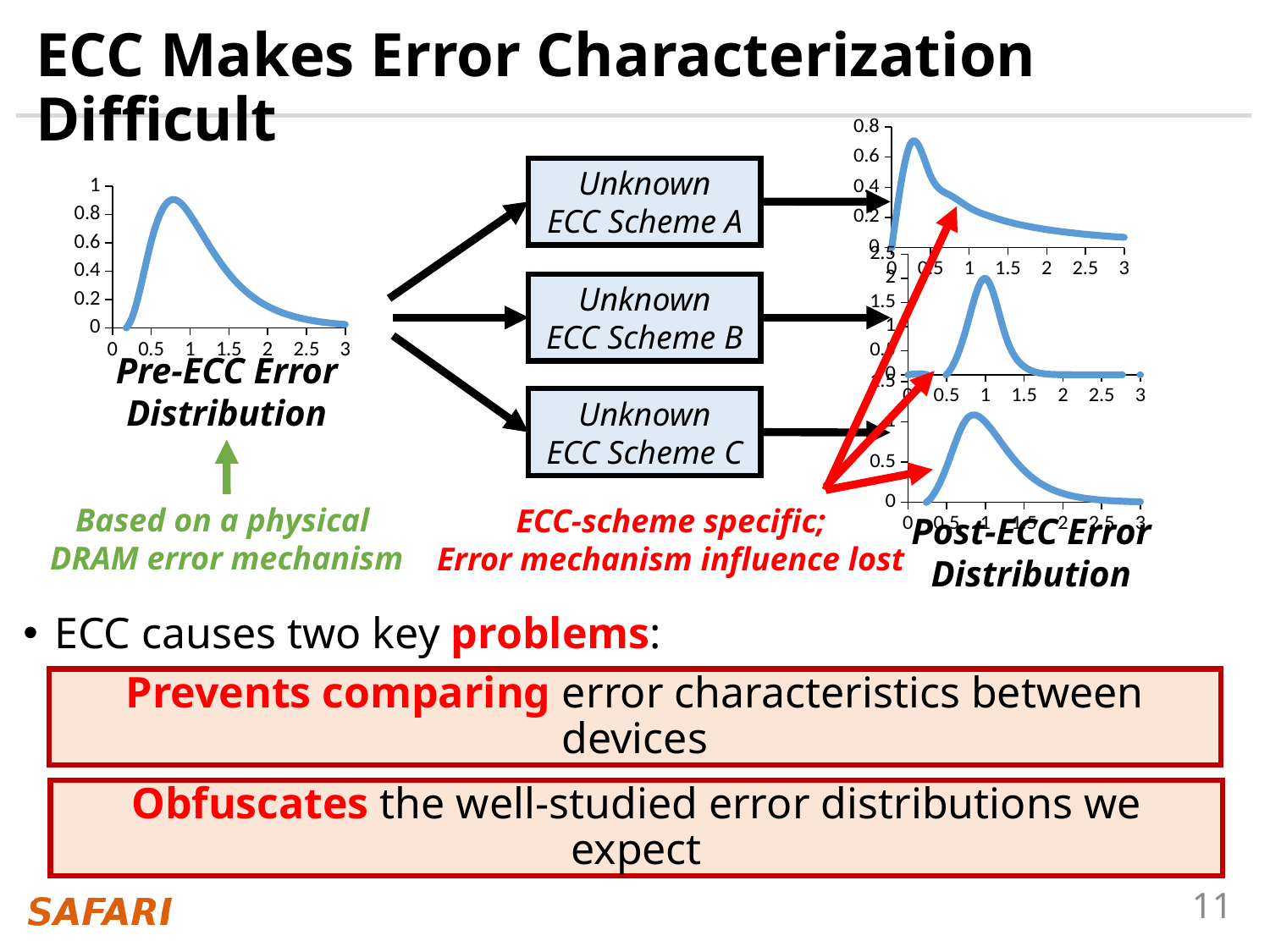
What is the highest tick shown on the y axis of the middle Post-ECC Error Distribution chart? 2.5 In the top Post-ECC Error Distribution chart, is the peak value greater or less than 0.6? greater In the Pre-ECC Error Distribution chart, do the values rise or fall along the x axis after the peak? fall In the top Post-ECC Error Distribution chart, is the value at x = 3 greater or less than 0.2? less In the Pre-ECC Error Distribution chart, is the value at x = 3 greater or less than 0.2? less What is the title of the chart on the left side of the slide? Pre-ECC Error Distribution How many charts are shown on the slide? 4 What kind of chart is the Pre-ECC Error Distribution chart? line chart